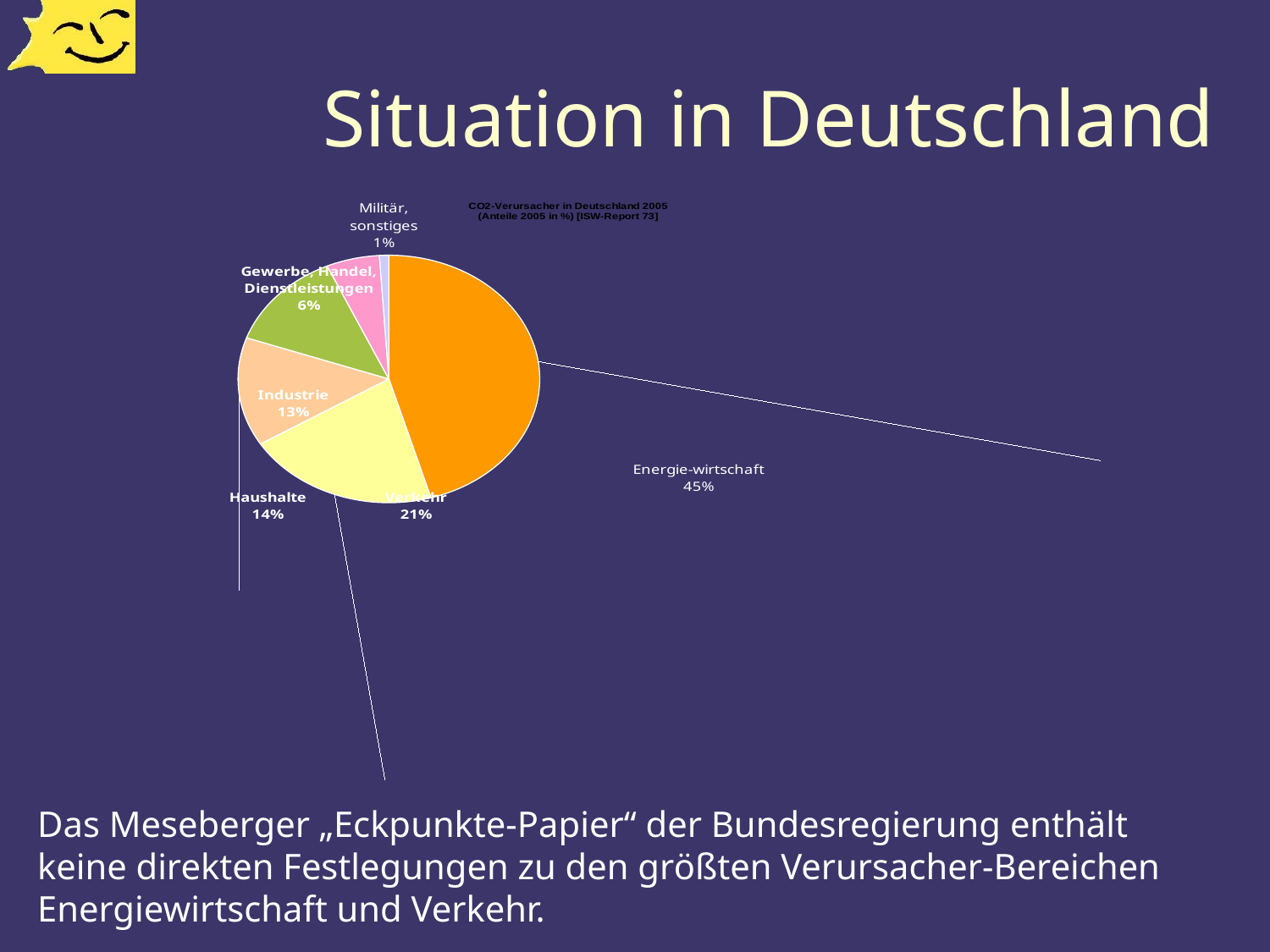
What is the difference in percentage points between Energie-wirtschaft and Verkehr? 24 Which is larger, the share for Haushalte or the share for Gewerbe, Handel, Dienstleistungen? Haushalte Which category has the largest slice of the pie? Energie-wirtschaft How many slices does the pie chart have? 6 Which category has the smallest slice of the pie? Militär, sonstiges What share of the pie does Haushalte have? 14% What share of the pie does Gewerbe, Handel, Dienstleistungen have? 6% What share of the pie does Energie-wirtschaft have? 45% What share of the pie does Verkehr have? 21% What is the title of the pie chart? CO2-Verursacher in Deutschland 2005 (Anteile 2005 in %) [ISW-Report 73] What share of the pie does Industrie have? 13% What kind of chart is shown on the slide? pie chart